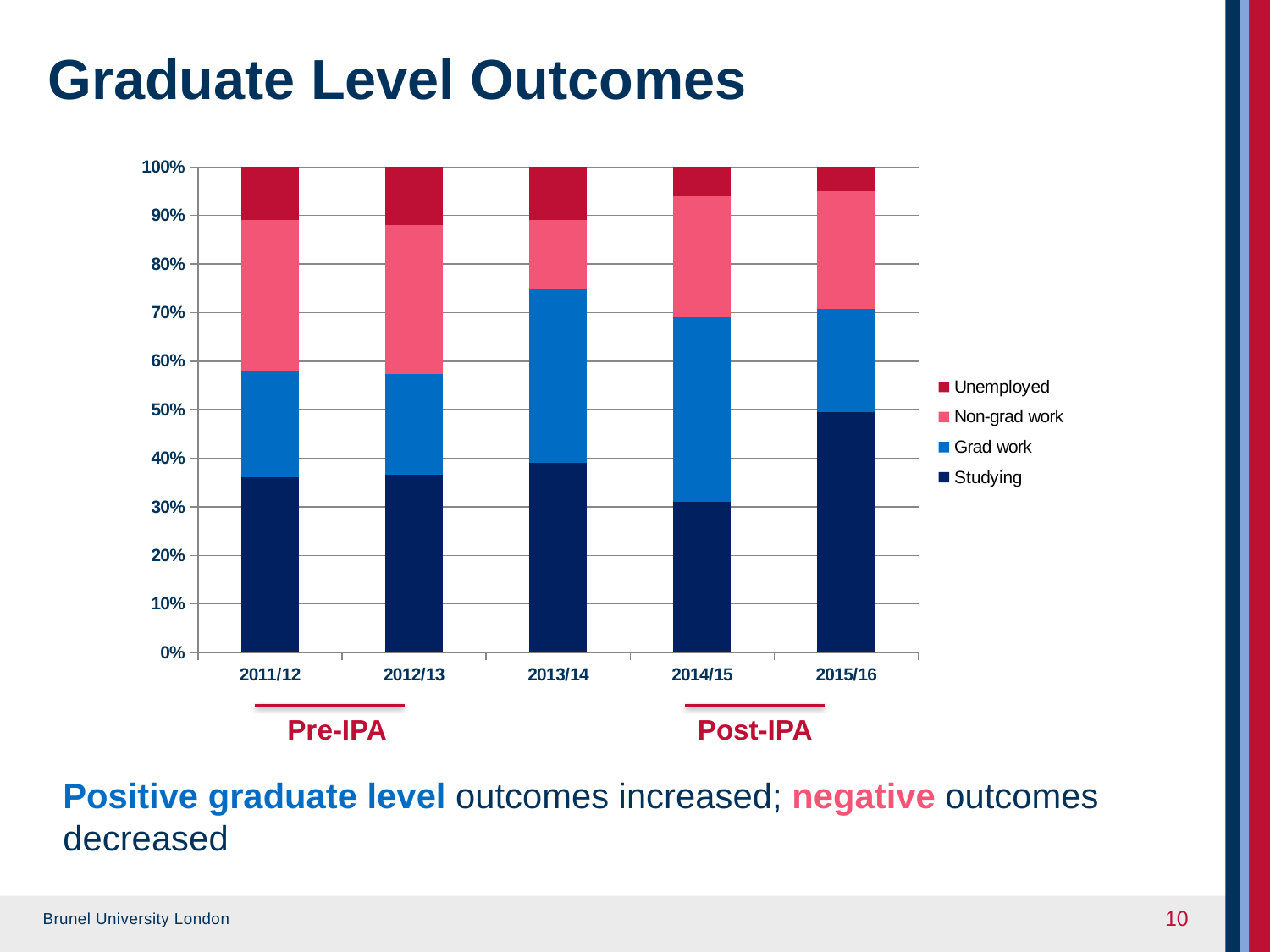
Is the Unemployed share for 2015/16 greater or less than 10%? less What kind of chart is shown on the slide? Stacked bar chart What is the total height of each stacked bar in the chart? 100% How many academic years are shown on the x axis of the chart? 5 Which year has the largest Studying share? 2015/16 Is the Unemployed segment larger in 2011/12 or in 2015/16? 2011/12 Which two labels are shown beneath the x axis to group the years? Pre-IPA and Post-IPA Which year has the smallest Non-grad work share? 2013/14 Is the Grad work segment larger in 2014/15 or in 2011/12? 2014/15 Is the Studying share for 2014/15 greater or less than 40%? less Which year has the smallest Studying share? 2014/15 How many series does the chart's legend list? 4